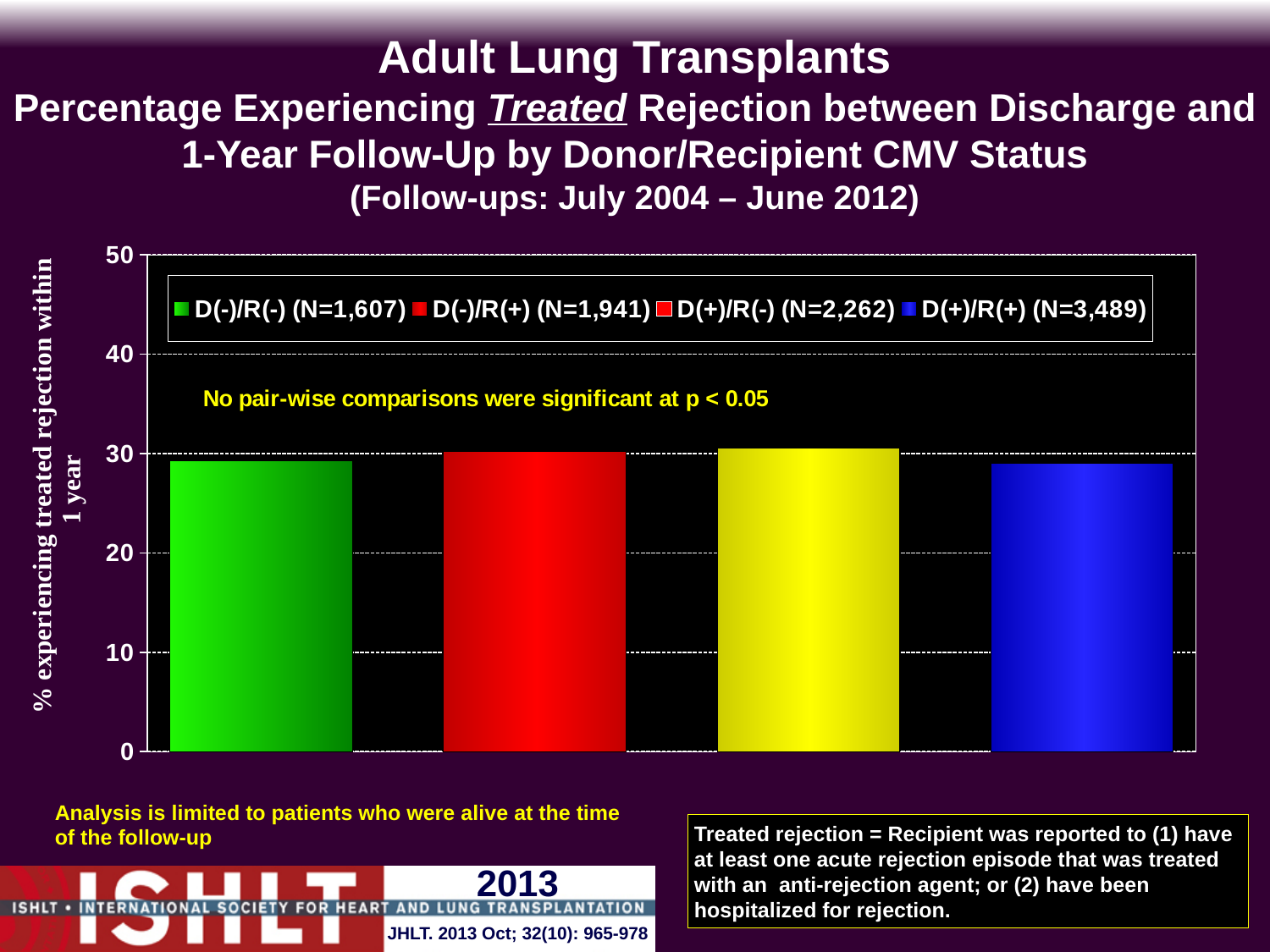
What is the maximum value shown on the y axis? 50 Is the value for D(-)/R(-) greater or less than 20? greater How many bars are plotted in the chart? 4 Is the value for D(-)/R(-) greater or less than 10? greater Is the value for D(-)/R(+) greater or less than 40? less How many series does the legend list? 4 What kind of chart is shown on the slide? bar chart What is the N for the D(+)/R(+) group shown in the legend? 3,489 What is the N for the D(-)/R(-) group shown in the legend? 1,607